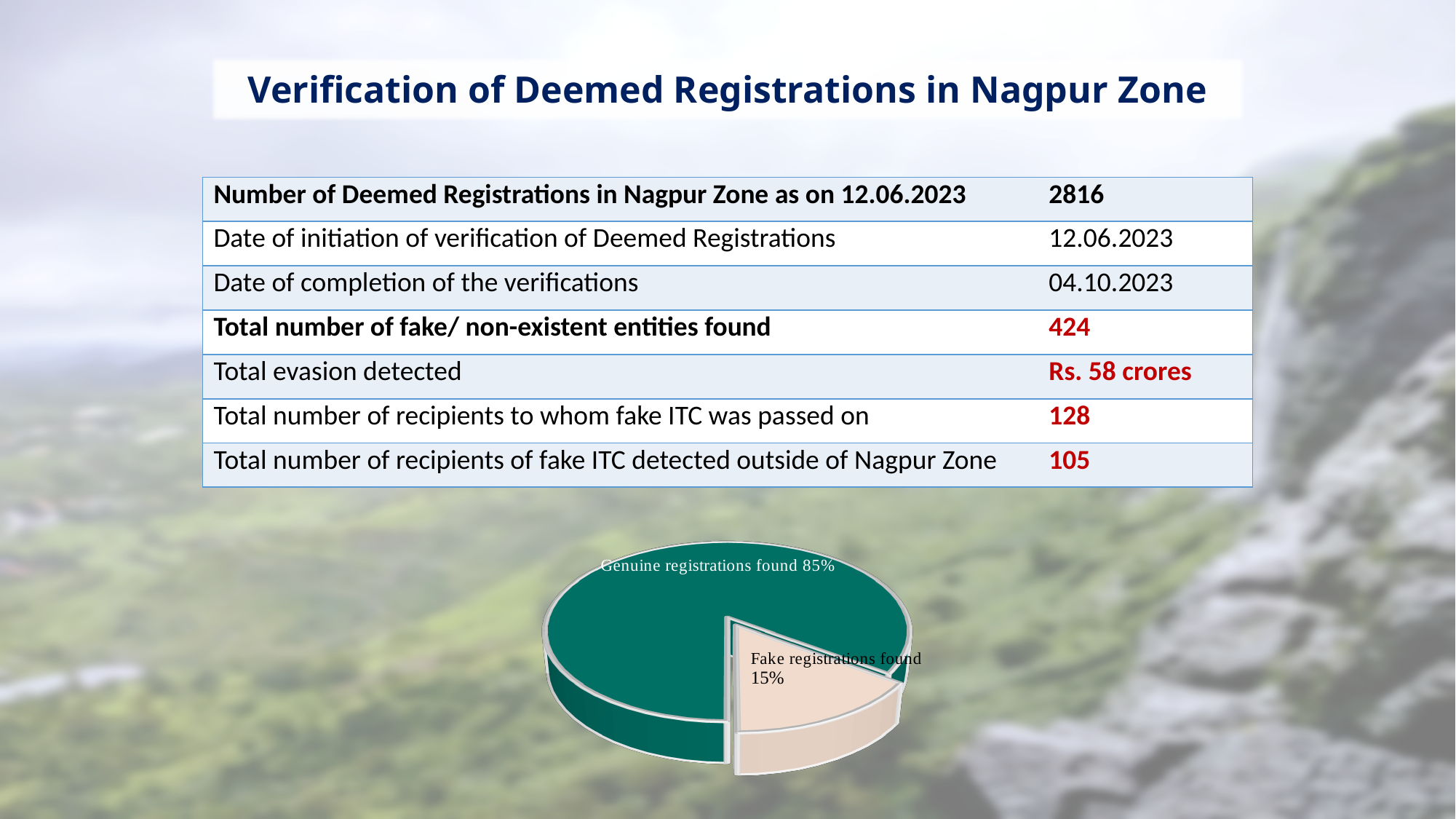
What kind of chart is shown on the slide? pie chart Which slice of the pie chart is the largest? Genuine registrations found What is the difference in percentage points between the 'Genuine registrations found' slice and the 'Fake registrations found' slice? 70 What share of the pie chart is labelled 'Fake registrations found'? 15% Which is larger in the pie chart: 'Genuine registrations found' or 'Fake registrations found'? Genuine registrations found How many slices does the pie chart have? 2 Which slice of the pie chart is pulled out (exploded) from the rest of the pie? Fake registrations found Which slice of the pie chart is the smallest? Fake registrations found What share of the pie chart is labelled 'Genuine registrations found'? 85% What colour is the 'Genuine registrations found' slice of the pie chart? dark green